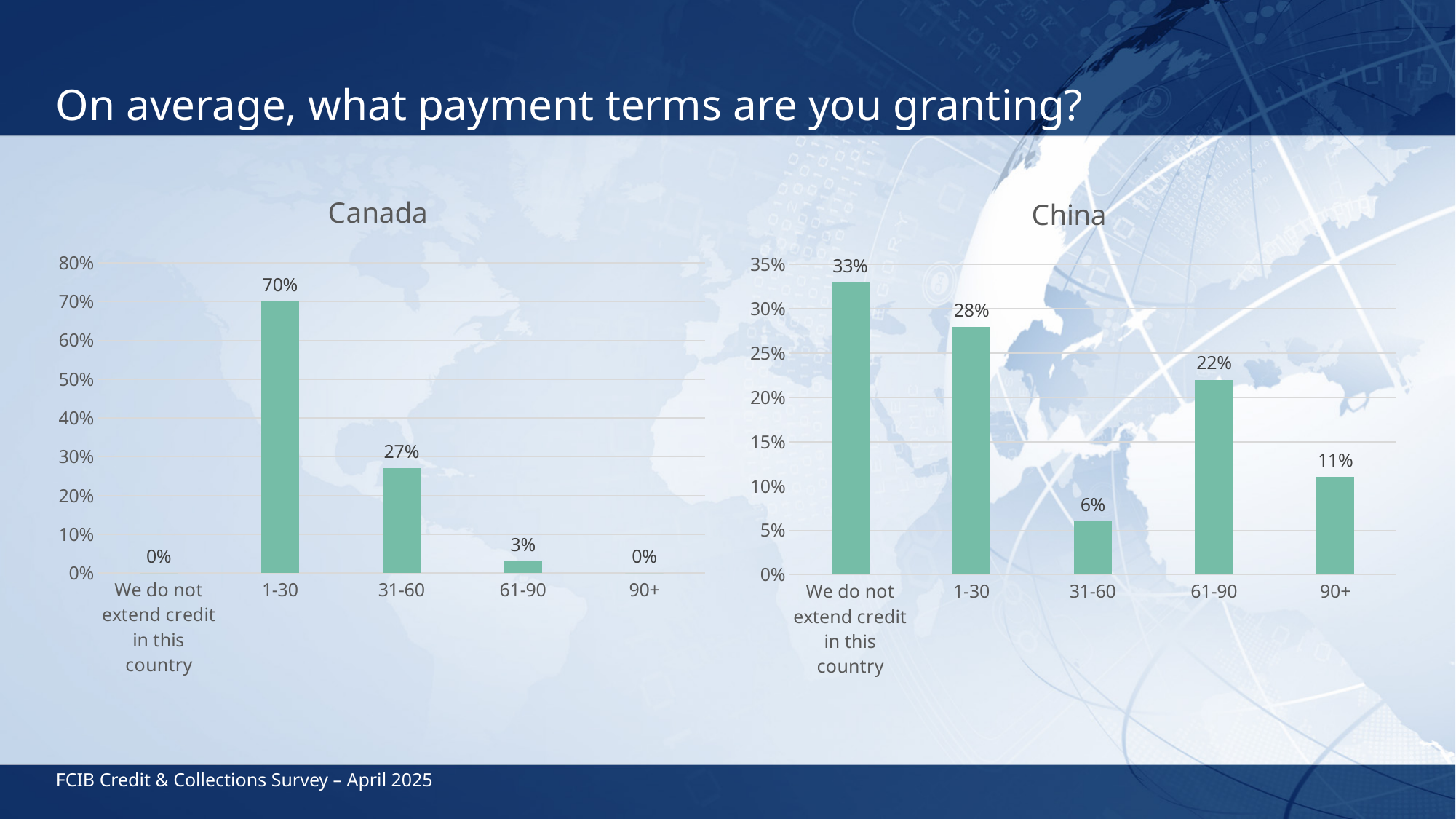
In the China chart, which category has the highest value? We do not extend credit in this country In the Canada chart, what is the difference between the values for 1-30 and 31-60? 43% In the China chart, what is the value for 31-60? 6% What kind of chart is the China chart? Bar chart How many categories are shown on the x axis of the Canada chart? 5 In the China chart, which category has the lowest value? 31-60 In the China chart, what is the difference between the values for 61-90 and 90+? 11% In the Canada chart, what is the value for 61-90? 3% In the Canada chart, which category has the highest value? 1-30 In the Canada chart, what is the value for 1-30? 70% In the China chart, which is larger, the value for 1-30 or the value for 61-90? 1-30 In the China chart, what is the value for 'We do not extend credit in this country'? 33%